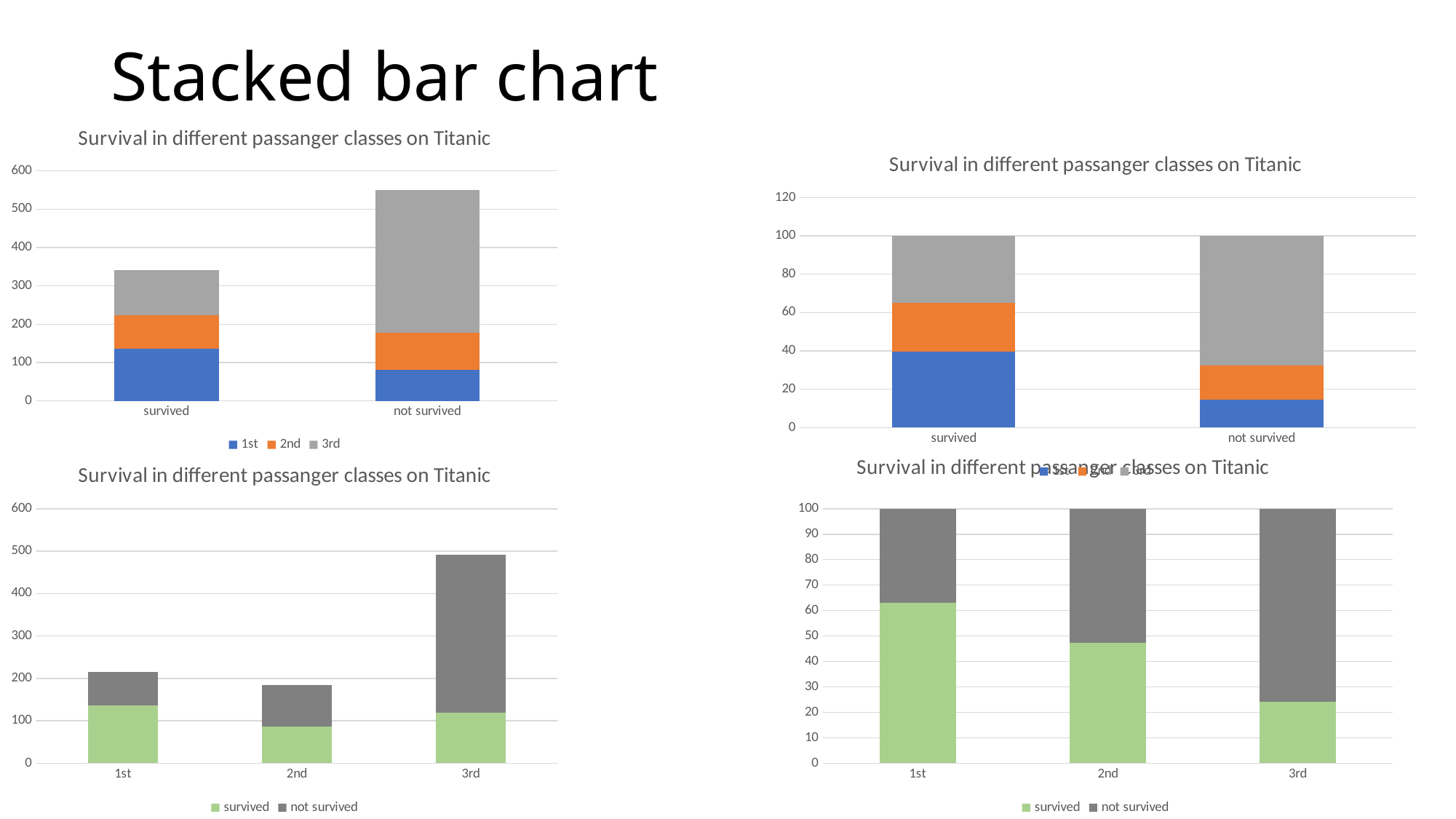
How many series does the legend of the bottom-right chart list? 2 How many passenger classes are shown on the x axis of the bottom-left chart? 3 In the top-left chart, is the total height of the 'survived' bar greater or less than 300? greater In the top-left chart, is the total height of the 'not survived' bar greater or less than 500? greater In the top-left chart, which category has the taller stacked bar? not survived In the bottom-right chart, which passenger class has the largest 'survived' segment? 1st How many series does the legend of the top-left chart list? 3 In the bottom-left chart, which passenger class has the tallest stacked bar? 3rd What kind of chart is the top-right chart? bar chart In the bottom-right chart, is the 'survived' segment for 3rd class greater or less than 30? less In the bottom-left chart, which passenger class has the shortest stacked bar? 2nd